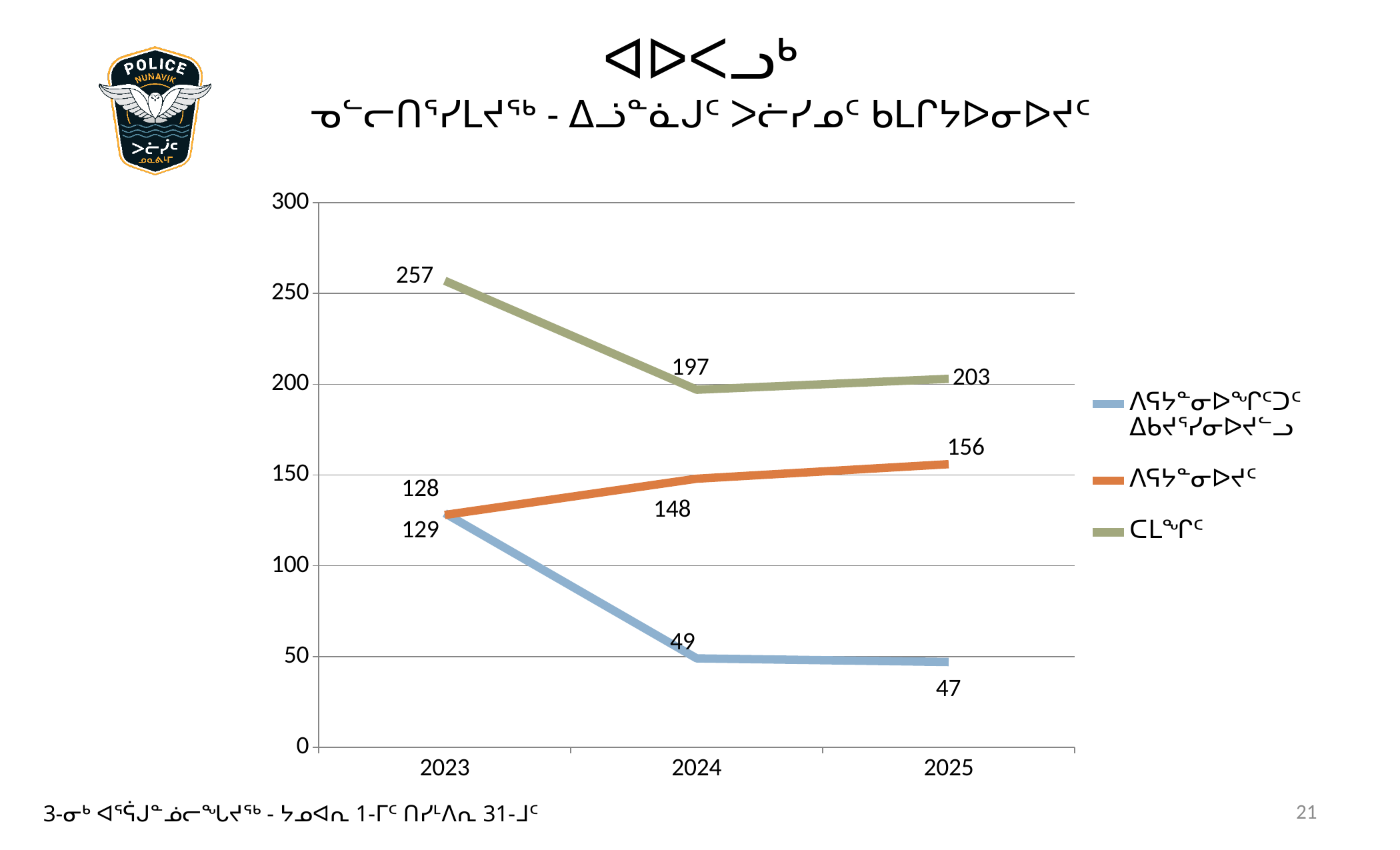
By how much did the green series fall from 2023 to 2024? 60 What is the value of the blue series in 2024? 49 How many years are shown on the x axis? 3 What kind of chart is shown on the slide? line chart What is the value of the green series in 2024? 197 Does the blue series rise or fall from 2023 to 2025? fall What is the difference between the orange series values in 2024 and 2025? 8 What is the value of the orange series in 2025? 156 How many series does the legend list? 3 Which series has the highest value in 2025? the green series What is the value of the blue series in 2025? 47 What is the value of the green series in 2023? 257